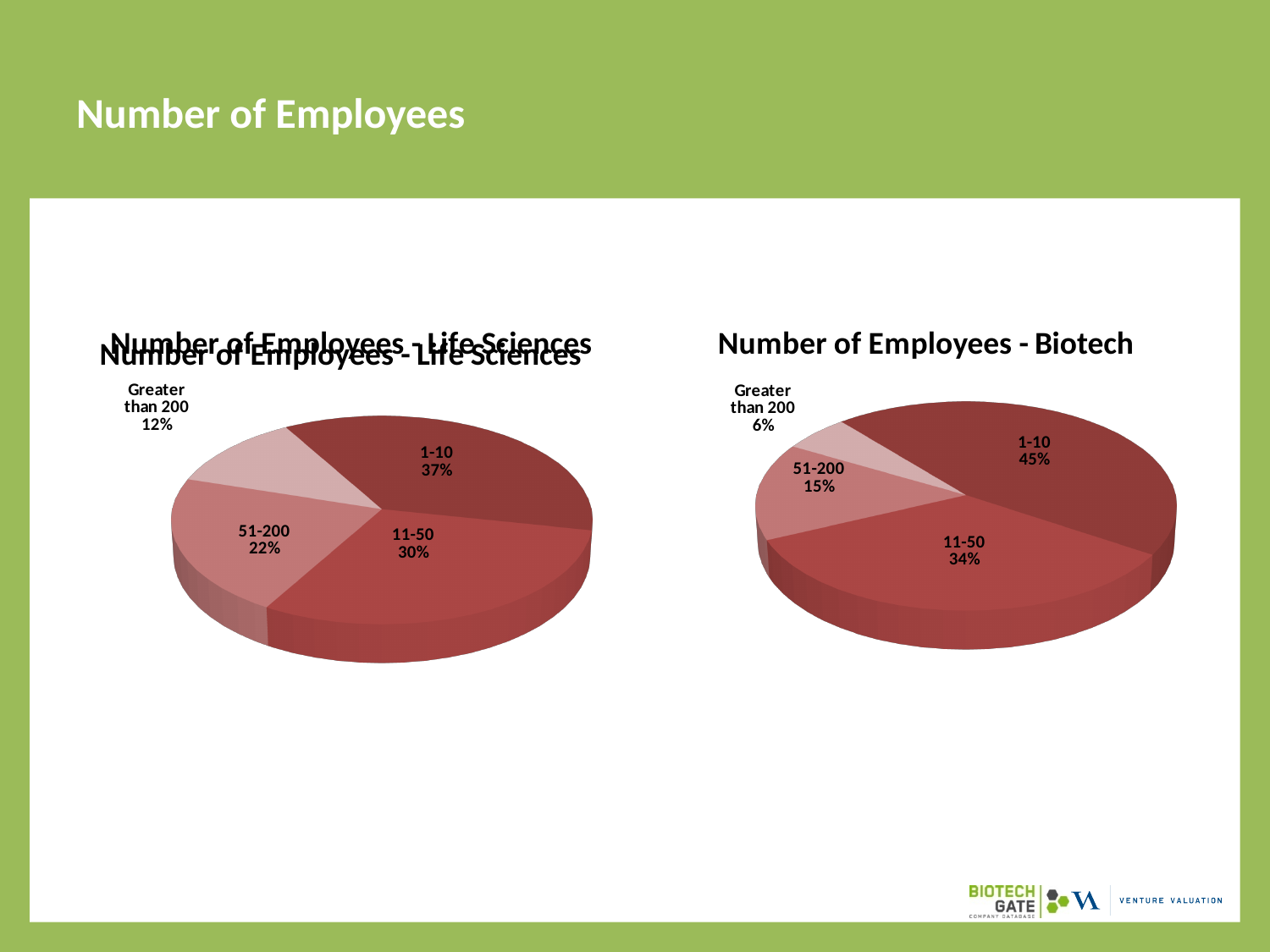
In the 'Number of Employees - Biotech' chart, what share do companies with 51-200 employees have? 15% In the 'Number of Employees - Biotech' chart, what share do companies with 11-50 employees have? 34% In the 'Number of Employees - Life Sciences' chart, what is the difference in percentage points between the 1-10 and 11-50 categories? 7 In the 'Number of Employees - Life Sciences' chart, what share do companies with greater than 200 employees have? 12% How many categories does the 'Number of Employees - Biotech' chart show? 4 In the 'Number of Employees - Biotech' chart, what is the difference in percentage points between the 1-10 and 11-50 categories? 11 In the 'Number of Employees - Biotech' chart, which category has the largest share? 1-10 In the 'Number of Employees - Life Sciences' chart, which is larger: the 51-200 share or the 11-50 share? 11-50 In the 'Number of Employees - Life Sciences' chart, which category has the smallest share? Greater than 200 In the 'Number of Employees - Life Sciences' chart, what share do companies with 1-10 employees have? 37% What type of chart is the 'Number of Employees - Life Sciences' chart? Pie chart In the 'Number of Employees - Biotech' chart, which category has the smallest share? Greater than 200